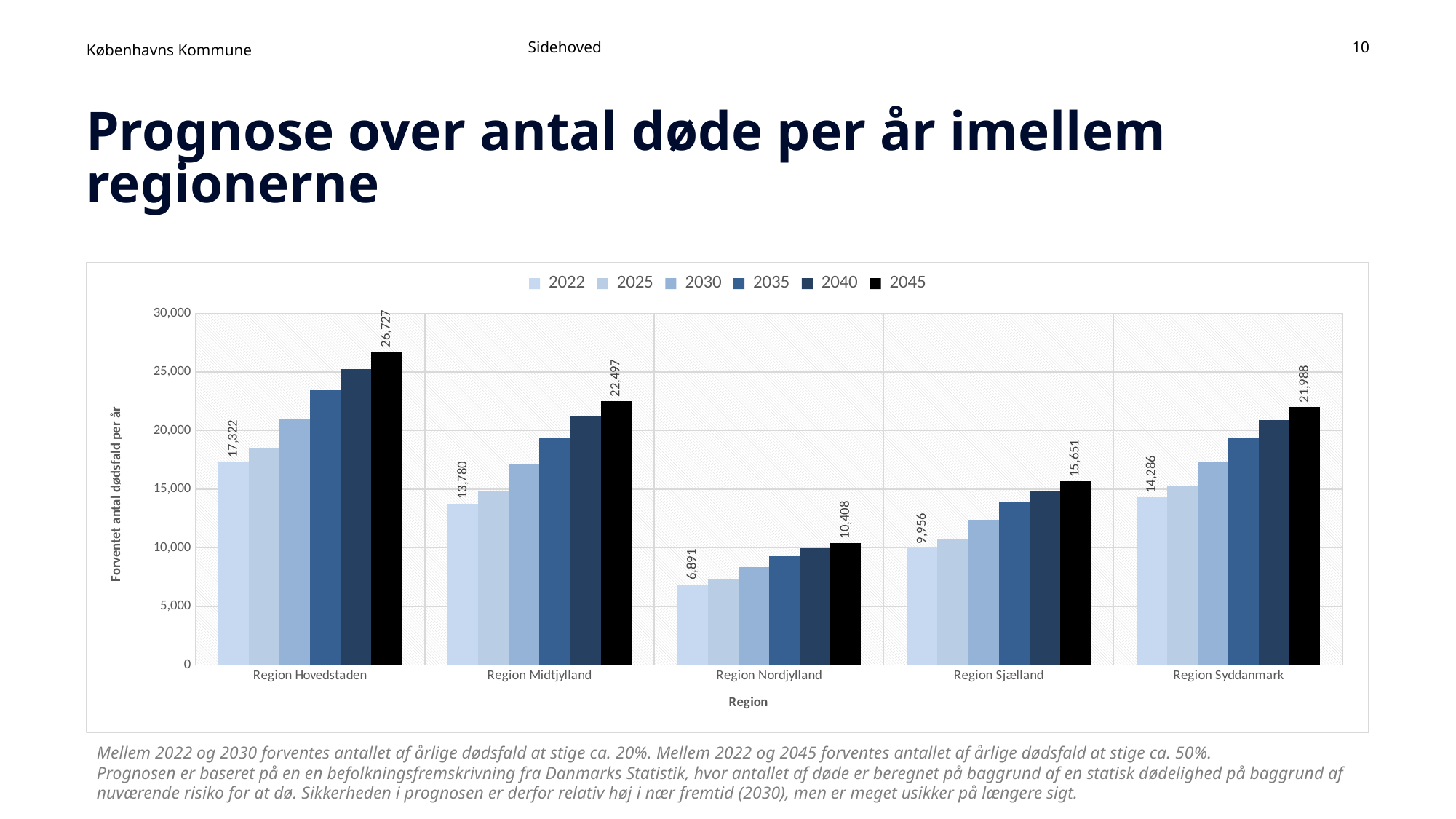
Which region has the lowest projected number of deaths in 2022? Region Nordjylland What is the projected number of deaths per year for Region Hovedstaden in 2045? 26,727 How many regions are shown on the x axis? 5 What is the value for Region Sjælland in 2045? 15,651 What is the value for Region Syddanmark in 2022? 14,286 Which region has the highest projected number of deaths in 2045? Region Hovedstaden How many series does the legend list? 6 By how much is the 2045 value for Region Hovedstaden higher than its 2022 value? 9,405 Which is larger in 2045: Region Midtjylland or Region Syddanmark? Region Midtjylland Is the value for Region Midtjylland in 2035 greater or less than 20,000? less What kind of chart is shown on the slide? bar chart What is the value for Region Nordjylland in 2022? 6,891